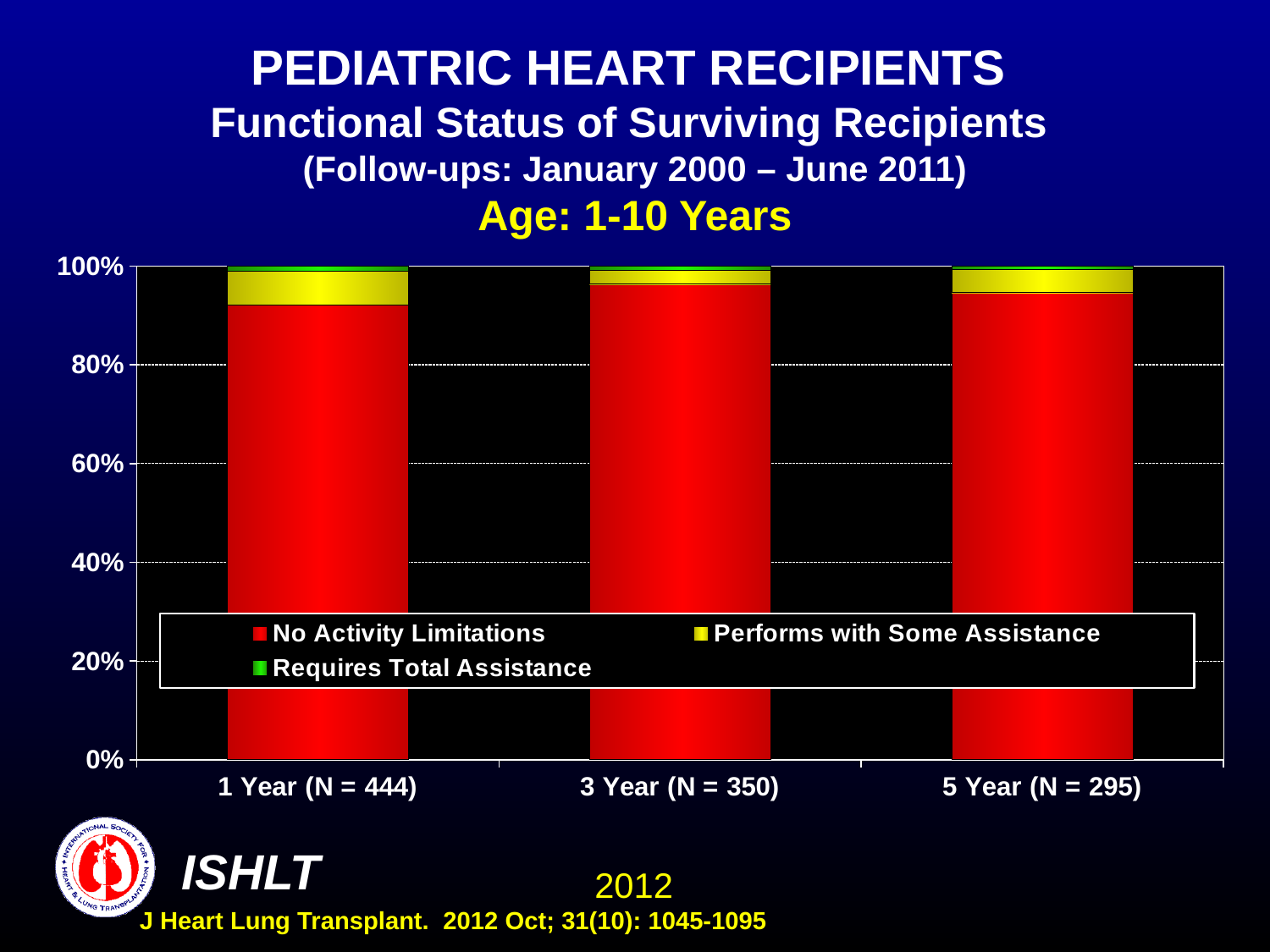
Is the No Activity Limitations share for 5 Year (N = 295) greater or less than 60%? greater Which series makes up the largest part of the 3 Year (N = 350) bar? No Activity Limitations Which series makes up the smallest part of the 1 Year (N = 444) bar? Requires Total Assistance Which series is shown in red in the legend? No Activity Limitations Is the Performs with Some Assistance share larger for 1 Year (N = 444) or for 3 Year (N = 350)? 1 Year (N = 444) How many series does the legend list? 3 Which series is shown in green in the legend? Requires Total Assistance What kind of chart is shown on the slide? stacked bar chart Is the Performs with Some Assistance share for 3 Year (N = 350) greater or less than 20%? less How many follow-up categories are shown on the x axis? 3 What is the total height of the 5 Year (N = 295) stacked bar? 100% Is the No Activity Limitations share for 1 Year (N = 444) greater or less than 80%? greater